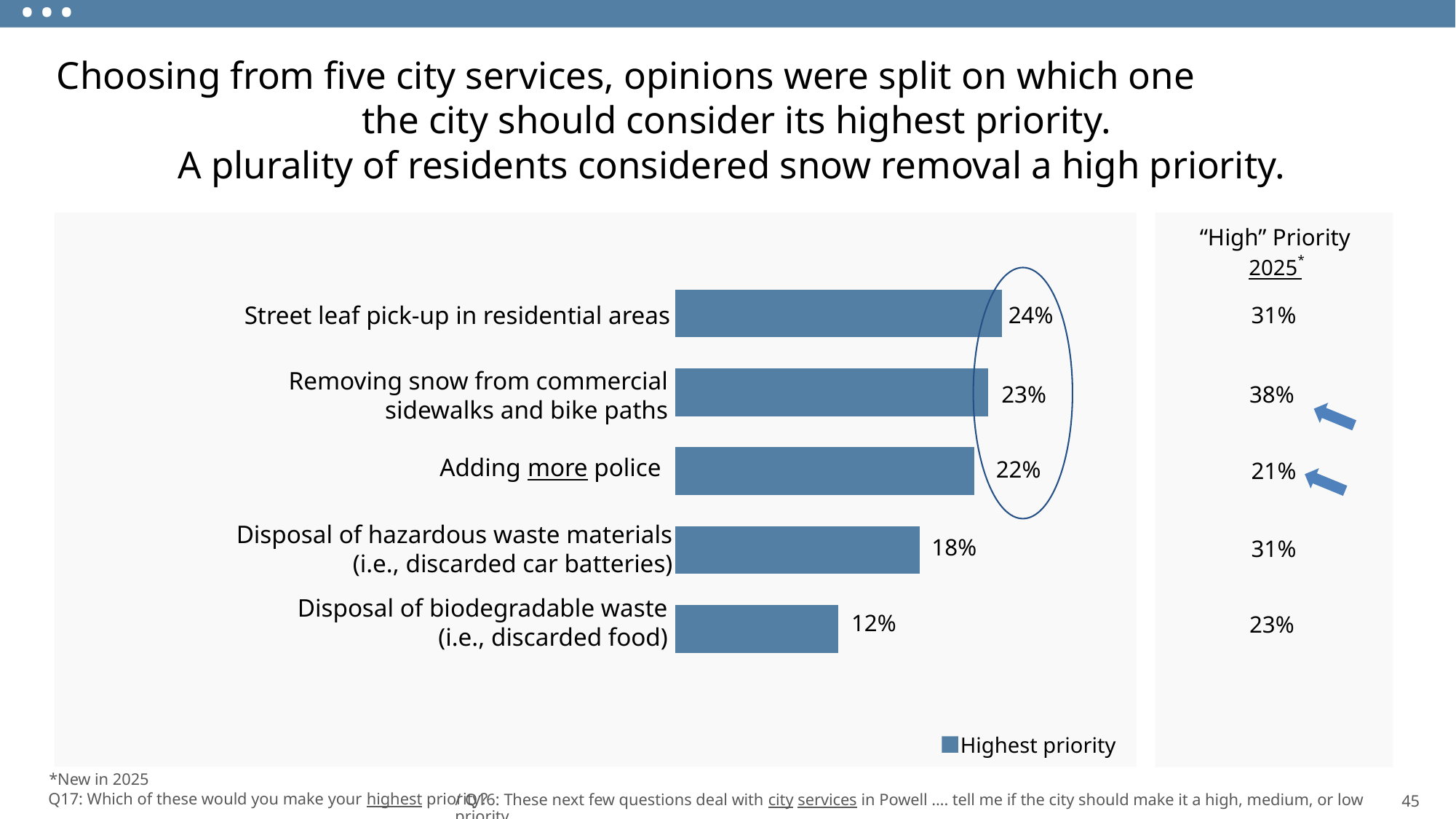
What is the value for disposal of hazardous waste materials (i.e., discarded car batteries)? 18% How many city services are shown in the bar chart? 5 How many series does the chart legend list? 1 Which city service has the highest percentage in the bar chart? Street leaf pick-up in residential areas What type of chart is shown on the slide? Bar chart What is the difference in percentage points between street leaf pick-up in residential areas and disposal of biodegradable waste? 12 What percentage is shown for disposal of biodegradable waste (i.e., discarded food)? 12% Which city service has the lowest percentage in the bar chart? Disposal of biodegradable waste (i.e., discarded food) What is the value shown for adding more police? 22% Which has a larger value: adding more police or disposal of hazardous waste materials? Adding more police What is the difference in percentage points between removing snow from commercial sidewalks and bike paths and disposal of hazardous waste materials? 5 What percentage of respondents chose street leaf pick-up in residential areas as their highest priority? 24%